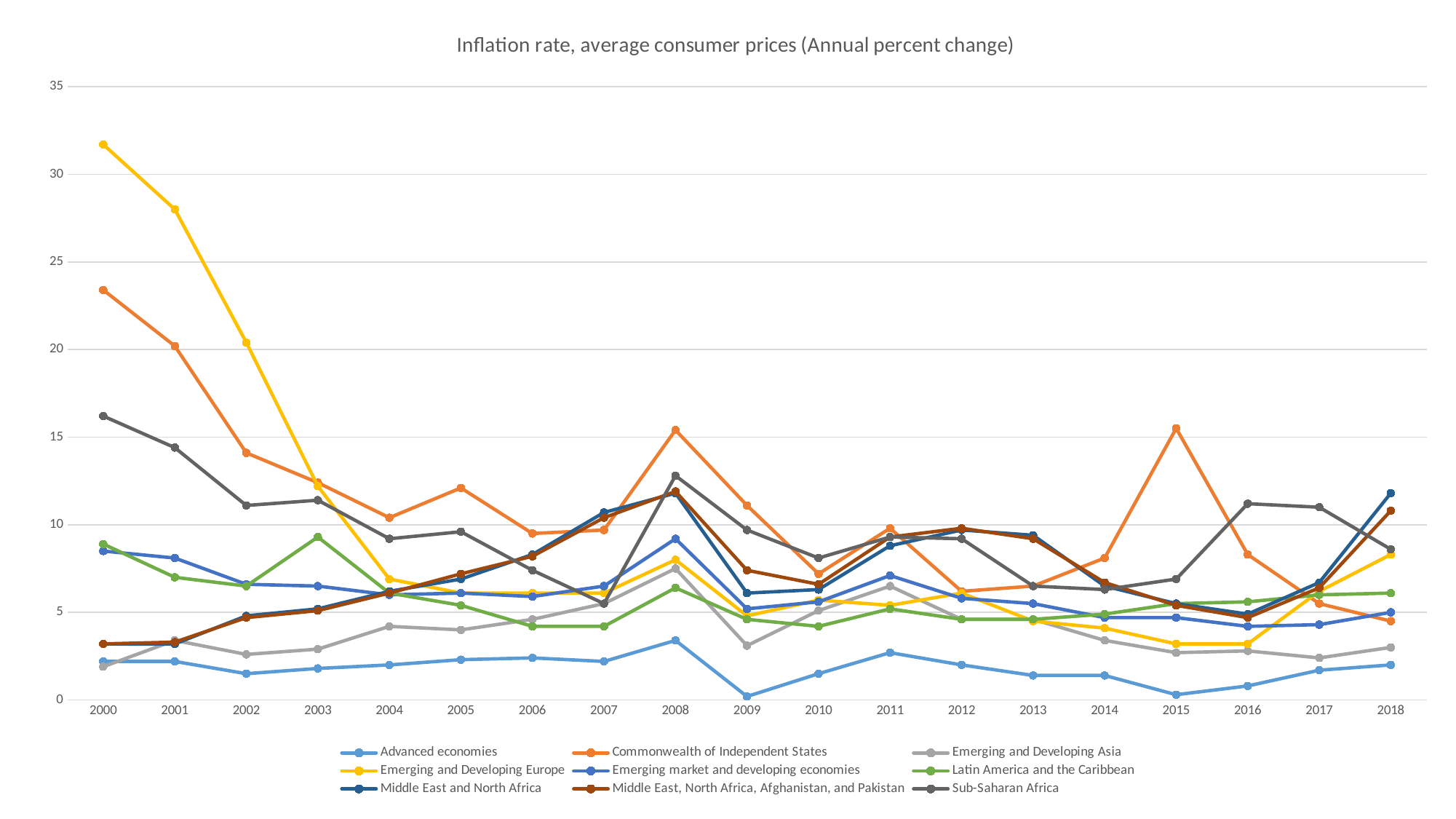
In 2008, which is larger: Commonwealth of Independent States or Sub-Saharan Africa? Commonwealth of Independent States Which series has the lowest value in 2015? Advanced economies Does the Emerging and Developing Europe line rise or fall from 2000 to 2004? fall Which series has the highest value in 2000? Emerging and Developing Europe Is the value for Emerging and Developing Europe in 2000 greater or less than 30? greater Is the value for Commonwealth of Independent States in 2015 greater or less than 10? greater How many years are shown along the x axis? 19 What is the title of the chart? Inflation rate, average consumer prices (Annual percent change) What kind of chart is shown on the slide? line chart How many series does the legend list? 9 Is the value for Sub-Saharan Africa in 2000 greater or less than 15? greater